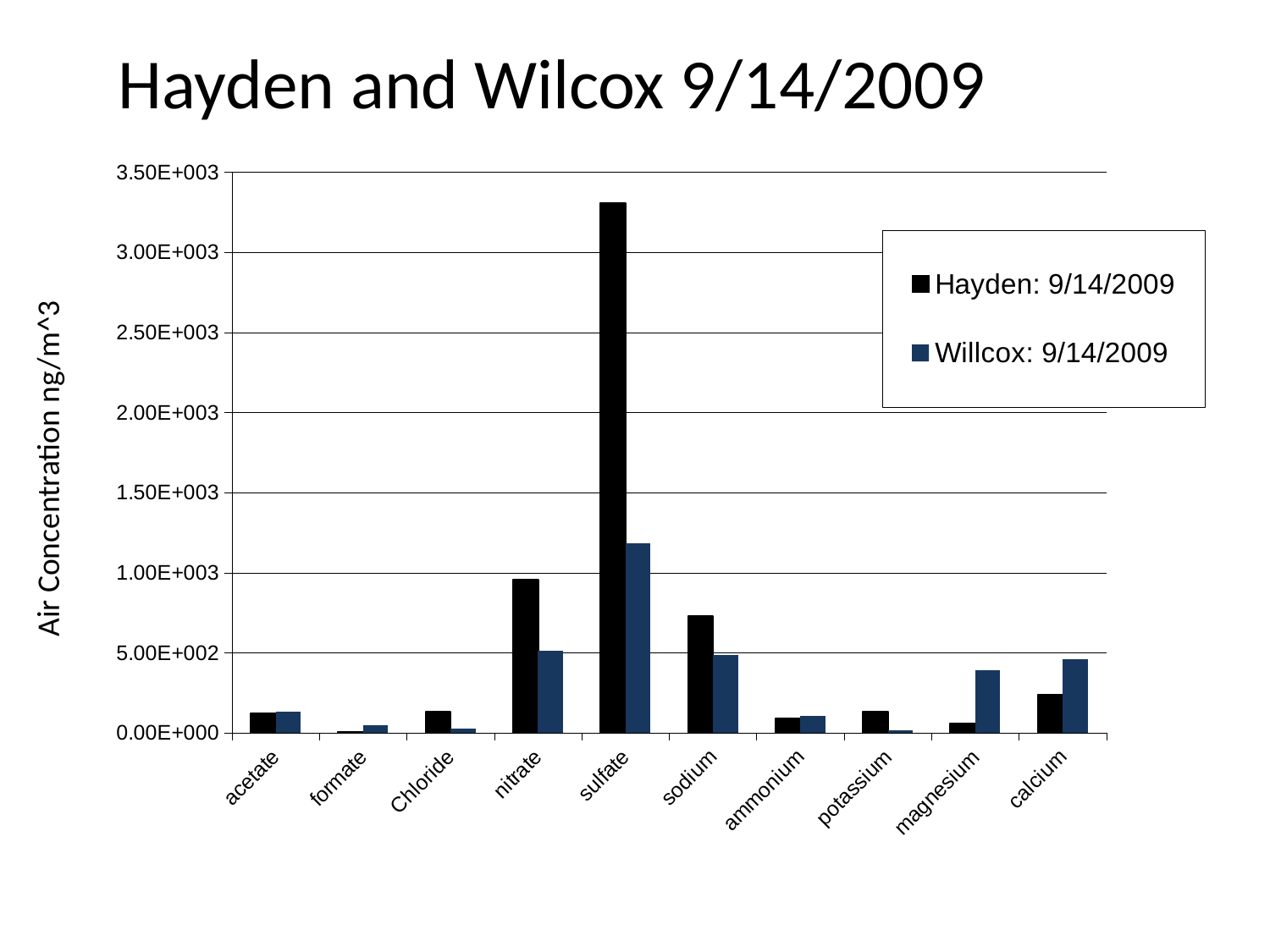
Which category has the highest value for the Willcox: 9/14/2009 series? sulfate How many series does the legend list? 2 Is the Willcox: 9/14/2009 value for sulfate greater or less than 1.00E+003? greater What kind of chart is shown on the slide? bar chart Which category has the highest value for the Hayden: 9/14/2009 series? sulfate Which category has the lowest value for the Hayden: 9/14/2009 series? formate How many categories are shown on the x axis? 10 Is the Hayden: 9/14/2009 value for sulfate greater or less than 3.00E+003? greater For magnesium, which series has the larger value, Hayden: 9/14/2009 or Willcox: 9/14/2009? Willcox: 9/14/2009 Is the Hayden: 9/14/2009 value for sodium greater or less than 5.00E+002? greater What is the title of the y axis? Air Concentration ng/m^3